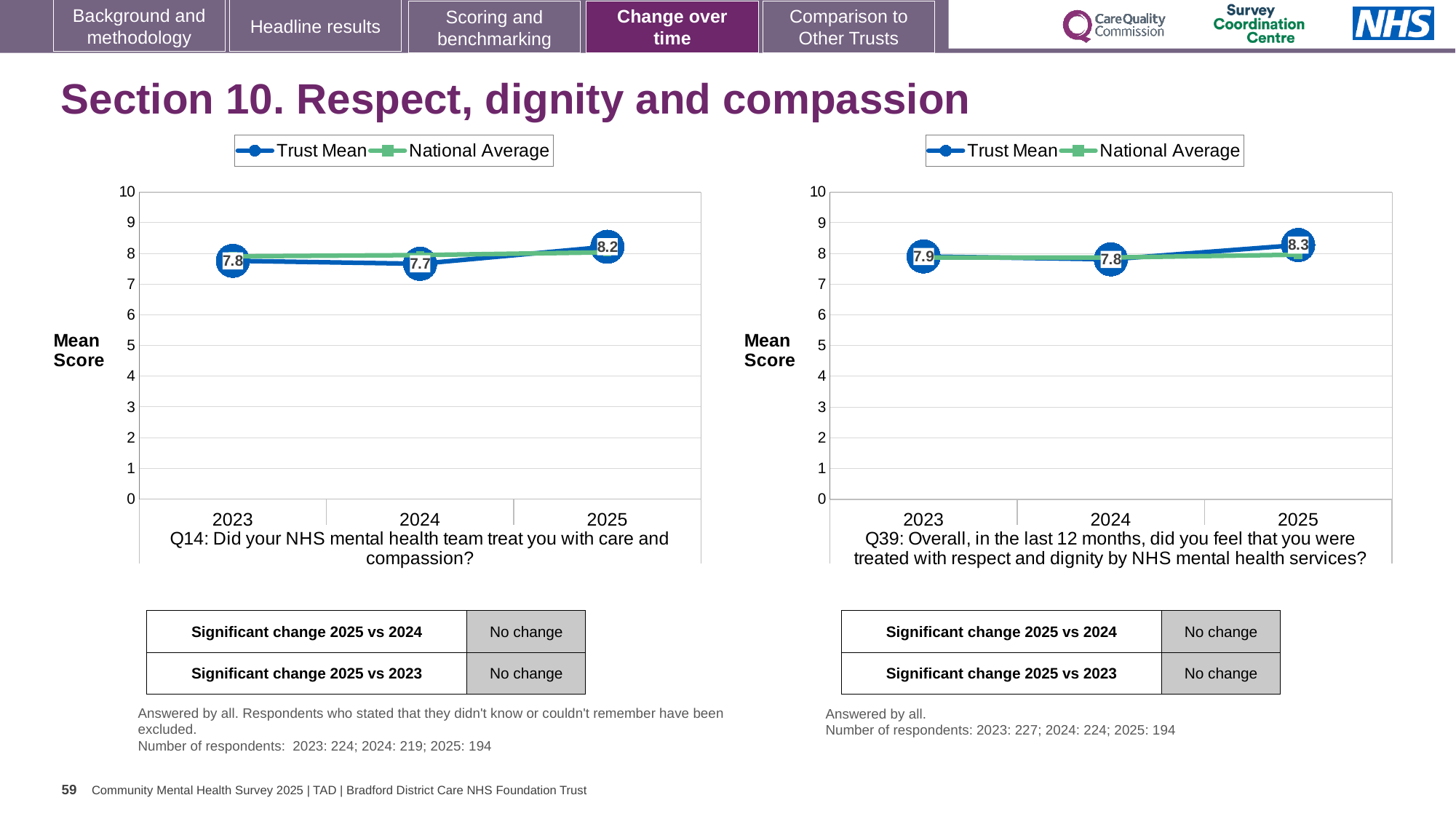
What type of chart is used for Q39 (right)? Line chart On the Q14 chart (left), what is the difference between the Trust Mean for 2025 and for 2024? 0.5 On the Q14 chart (left), which year has the highest Trust Mean? 2025 How many series does the legend of the Q14 chart (left) list? 2 On the Q39 chart (right), what is the Trust Mean for 2025? 8.3 On the Q14 chart (left), is the National Average for 2025 greater or less than 7? greater On the Q14 chart (left), what is the Trust Mean for 2024? 7.7 On the Q14 chart (left), what is the Trust Mean for 2025? 8.2 On the Q39 chart (right), is the Trust Mean for 2025 larger or smaller than the Trust Mean for 2023? larger On the Q39 chart (right), which year has the lowest Trust Mean? 2024 On the Q39 chart (right), what is the Trust Mean for 2023? 7.9 How many years are shown on the x axis of the Q39 chart (right)? 3